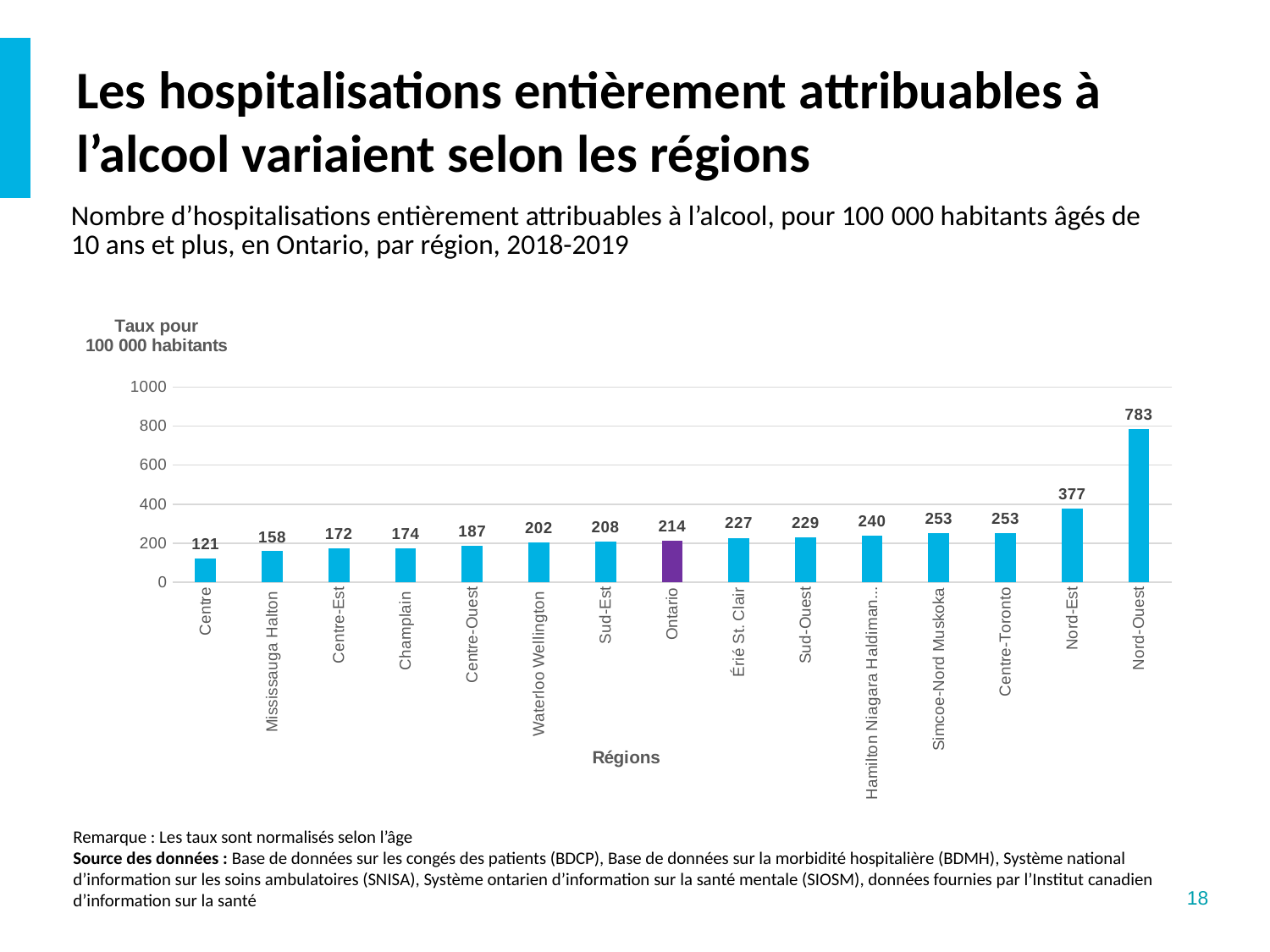
Which region has the lowest rate? Centre How many bars are shown in the chart? 15 What is the value for Champlain? 174 What kind of chart is shown on the slide? bar chart What is the value for Nord-Ouest? 783 What is the label of the x axis? Régions What is the value for Ontario? 214 What is the difference between the values for Nord-Ouest and Nord-Est? 406 Which region has the highest rate? Nord-Ouest What is the difference between the values for Ontario and Centre? 93 Is the value for Nord-Est greater or less than 400? less Which is larger, the value for Sud-Est or the value for Mississauga Halton? Sud-Est